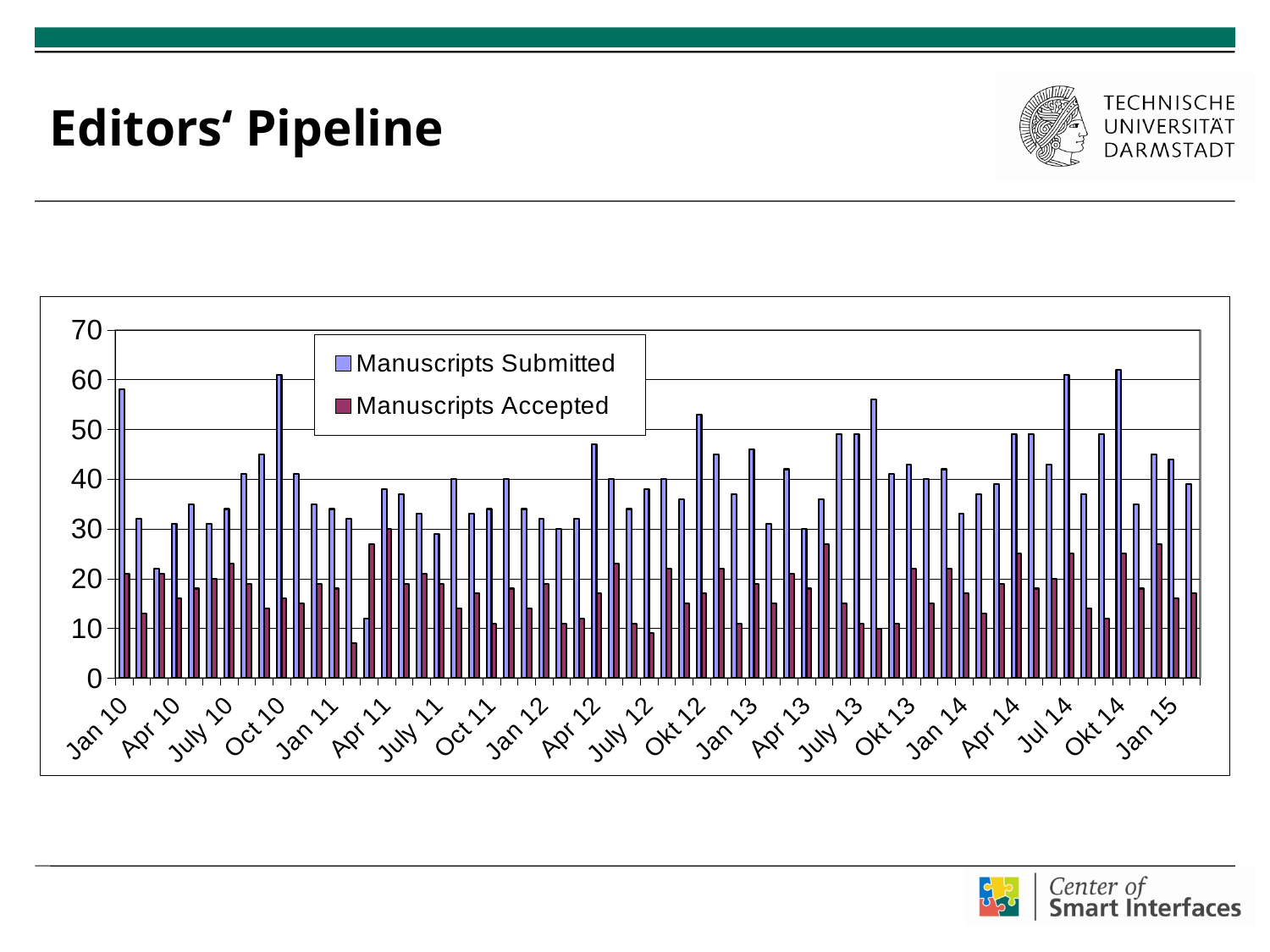
How many series does the legend list? 2 Is the Manuscripts Accepted value for Jan 10 greater or less than 30? less How many category labels are shown along the x axis? 21 Is the Manuscripts Submitted value for Jan 15 greater or less than 30? greater Is the Manuscripts Accepted value for Jan 10 greater or less than 10? greater What is the highest value shown on the y axis? 70 What are the two series named in the legend? Manuscripts Submitted and Manuscripts Accepted For Jan 10, which is larger: Manuscripts Submitted or Manuscripts Accepted? Manuscripts Submitted What kind of chart is shown on the slide? bar chart What is the title of the slide containing the chart? Editors' Pipeline